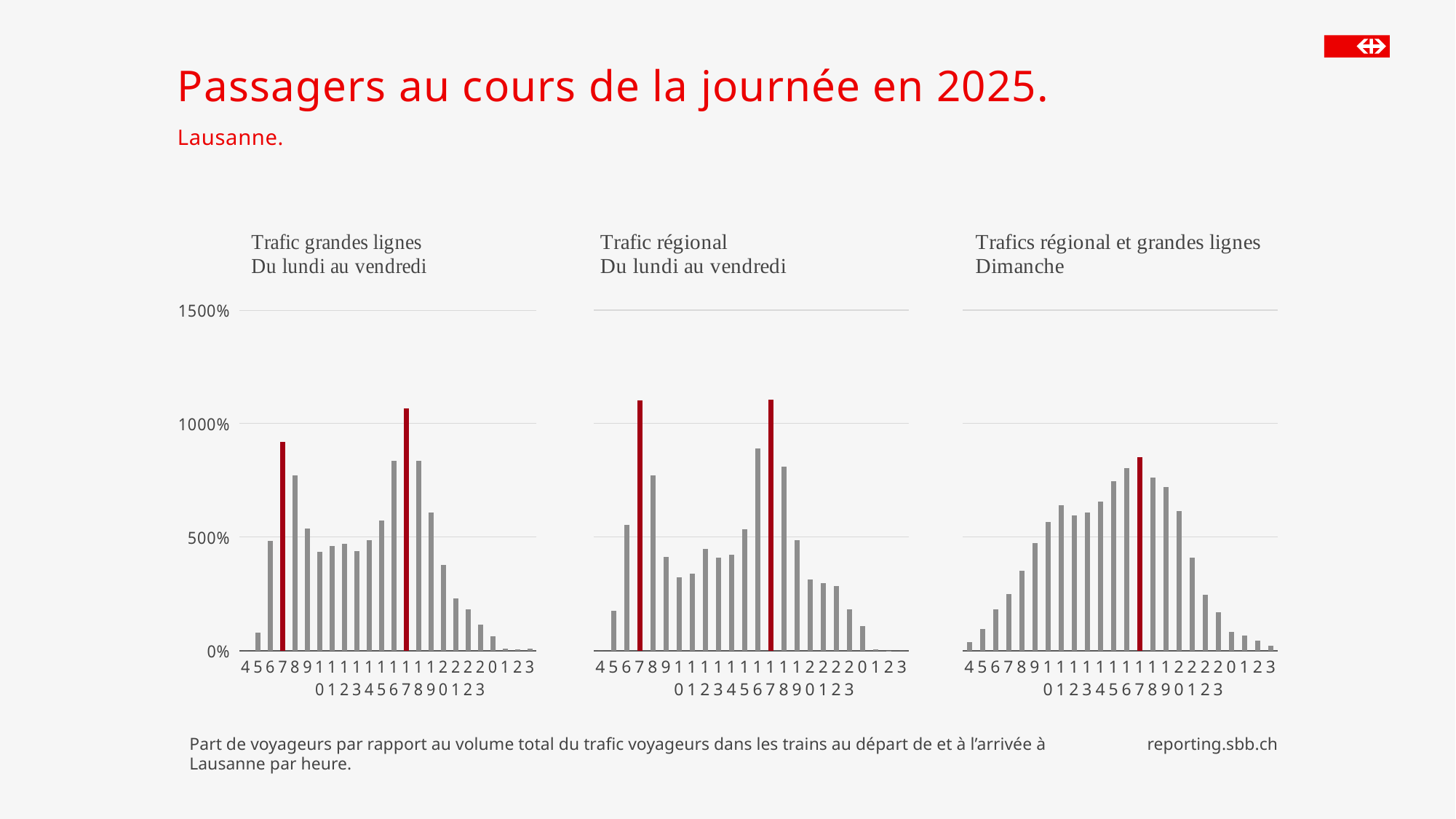
In the "Trafics régional et grandes lignes Dimanche" chart, do the values rise or fall from hour 4 to hour 17? rise In the "Trafic régional Du lundi au vendredi" chart, how many hourly categories are plotted on the x axis? 24 How many charts are shown on the slide? 3 In the "Trafic grandes lignes Du lundi au vendredi" chart, is the value for hour 7 greater or less than 1000%? less In the "Trafic grandes lignes Du lundi au vendredi" chart, is the value for hour 17 greater or less than 1000%? greater In the "Trafics régional et grandes lignes Dimanche" chart, is the value for hour 17 greater or less than 1000%? less In the "Trafic grandes lignes Du lundi au vendredi" chart, which hour has the highest bar? 17 What kind of chart is used for "Trafic grandes lignes Du lundi au vendredi"? bar chart In the "Trafics régional et grandes lignes Dimanche" chart, which is larger, the value for hour 17 or the value for hour 4? hour 17